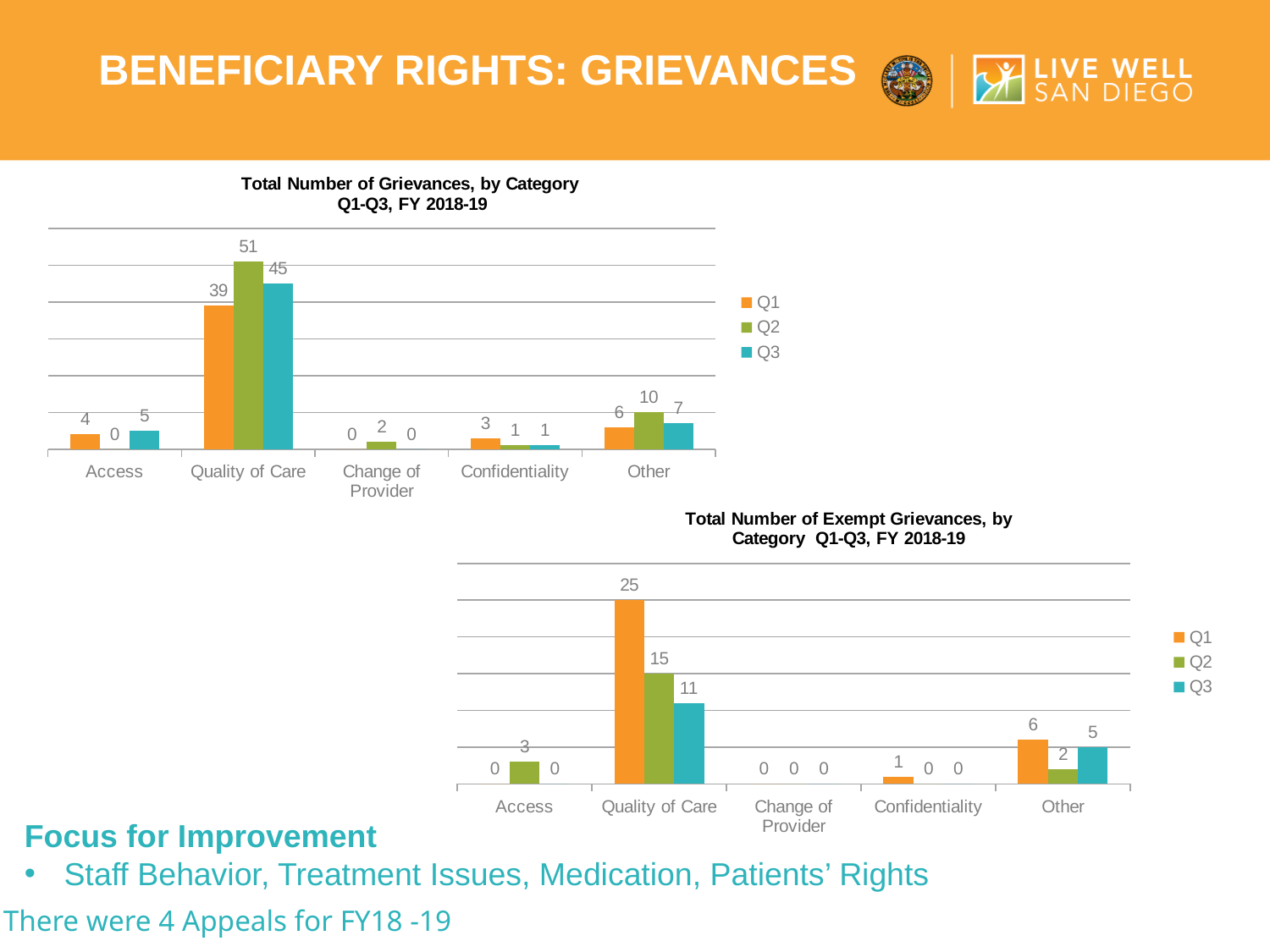
In the 'Total Number of Exempt Grievances, by Category Q1-Q3, FY 2018-19' chart, which is larger for Other: the Q1 value or the Q2 value? Q1 In the 'Total Number of Grievances, by Category Q1-Q3, FY 2018-19' chart, what is the Q1 value for Access? 4 In the 'Total Number of Exempt Grievances, by Category Q1-Q3, FY 2018-19' chart, what is the Q1 value for Quality of Care? 25 In the 'Total Number of Grievances, by Category Q1-Q3, FY 2018-19' chart, how many categories are shown on the x axis? 5 In the 'Total Number of Grievances, by Category Q1-Q3, FY 2018-19' chart, how many series does the legend list? 3 What kind of chart is the 'Total Number of Exempt Grievances, by Category Q1-Q3, FY 2018-19' chart? bar chart In the 'Total Number of Exempt Grievances, by Category Q1-Q3, FY 2018-19' chart, do the Quality of Care values rise or fall from Q1 to Q3? fall In the 'Total Number of Grievances, by Category Q1-Q3, FY 2018-19' chart, what is the Q2 value for Quality of Care? 51 In the 'Total Number of Grievances, by Category Q1-Q3, FY 2018-19' chart, which category has the highest Q3 value? Quality of Care In the 'Total Number of Exempt Grievances, by Category Q1-Q3, FY 2018-19' chart, what is the Q3 value for Other? 5 In the 'Total Number of Exempt Grievances, by Category Q1-Q3, FY 2018-19' chart, what is the difference between the Q1 and Q3 values for Quality of Care? 14 In the 'Total Number of Grievances, by Category Q1-Q3, FY 2018-19' chart, what is the difference between the Q2 and Q1 values for Quality of Care? 12